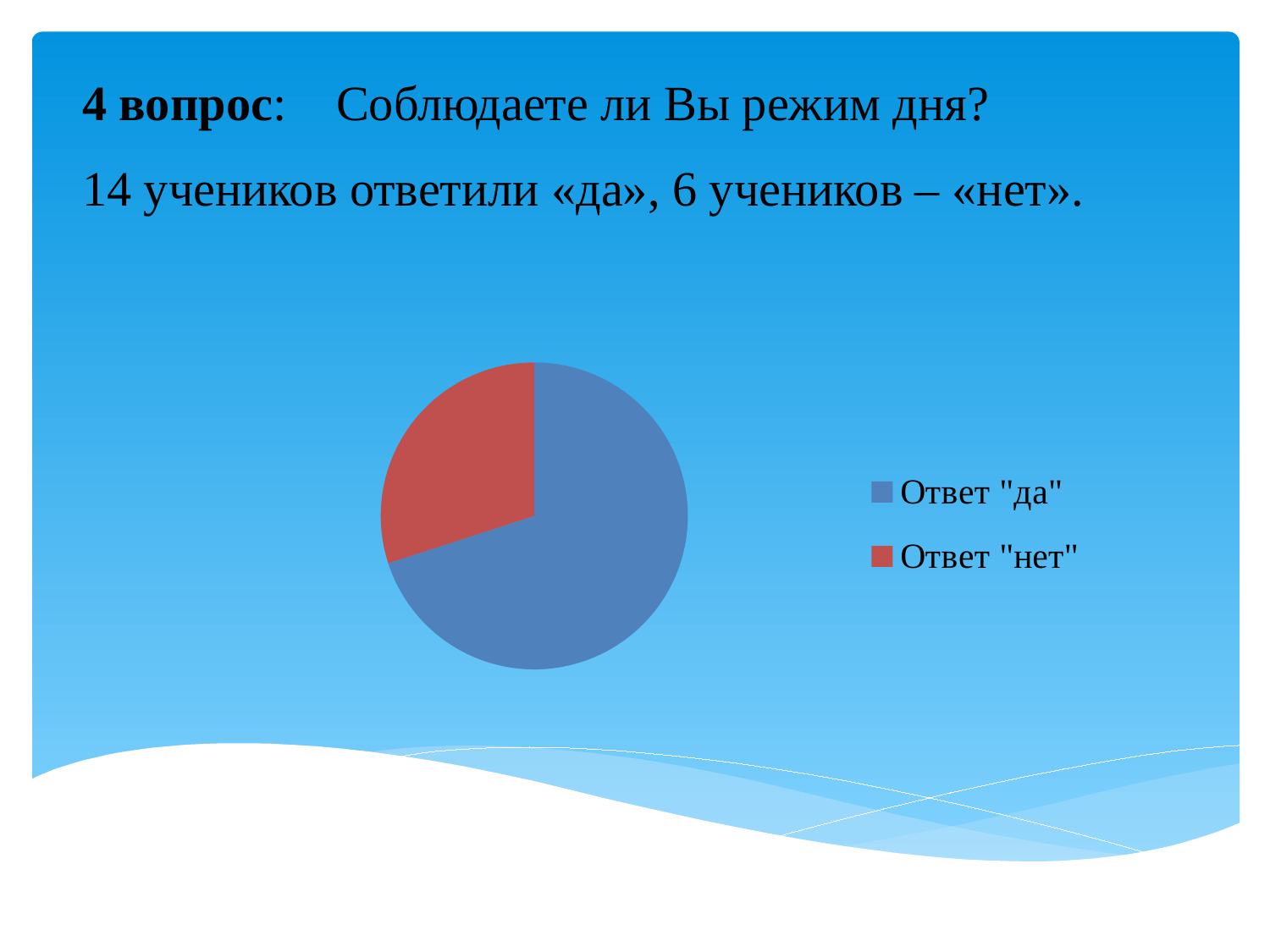
What kind of chart is shown on the slide? pie chart How many entries does the legend of the pie chart list? 2 What share of the pie does the Ответ "да" slice represent? 70% How many more students answered "да" than "нет"? 8 Which is larger in the pie chart: Ответ "да" or Ответ "нет"? Ответ "да" According to the slide, how many students answered "нет"? 6 How many slices does the pie chart have? 2 Which slice of the pie chart is the smallest? Ответ "нет" What colour is the Ответ "нет" slice in the pie chart? red Which slice of the pie chart is the largest? Ответ "да" What are the two legend entries of the pie chart? Ответ "да" and Ответ "нет" According to the slide, how many students answered "да"? 14